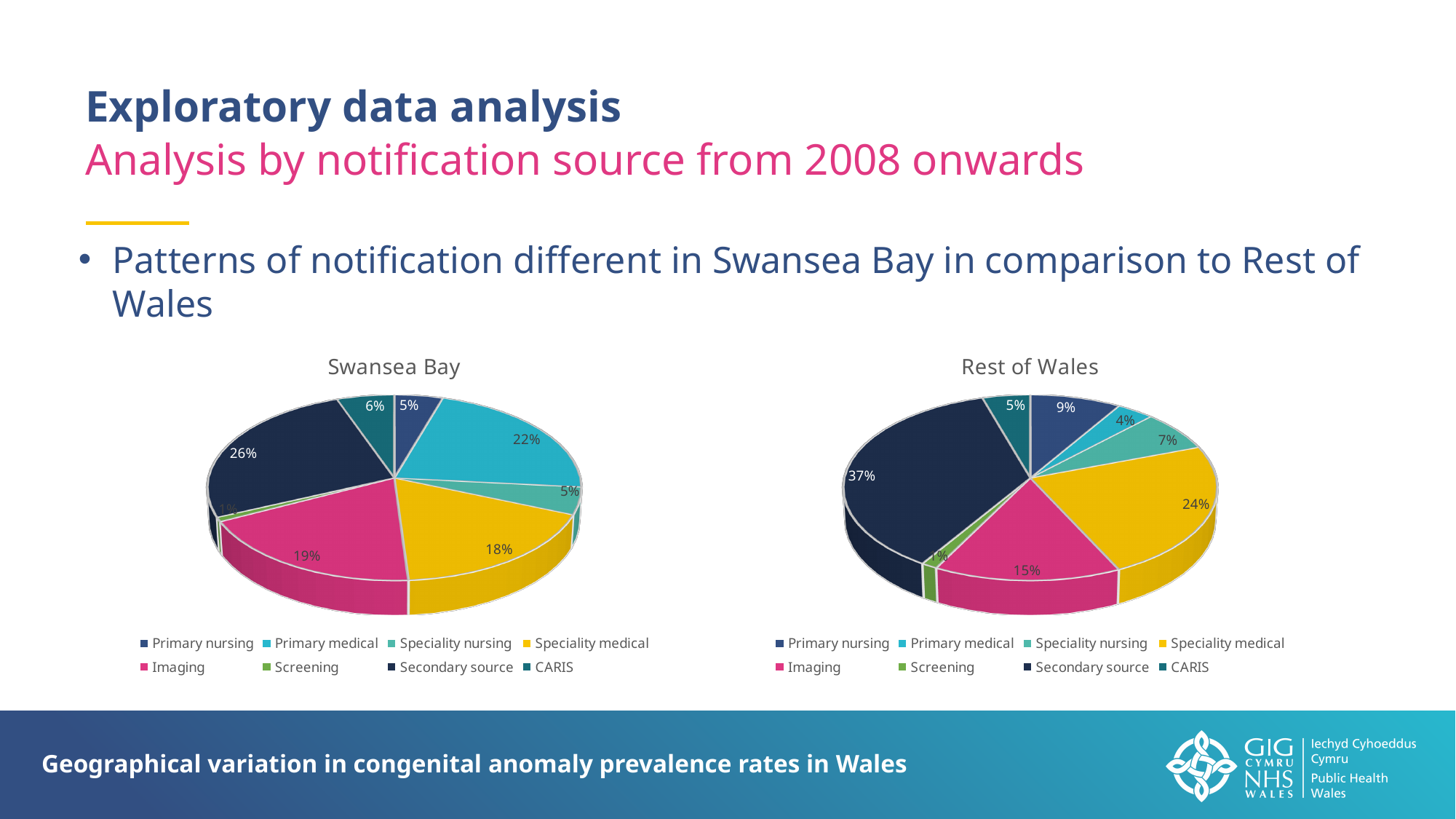
In the Swansea Bay pie chart, what percentage is shown for Primary medical? 22% In the Rest of Wales pie chart, what share does Primary nursing account for? 9% In the Rest of Wales pie chart, what share does Secondary source account for? 37% In the Swansea Bay pie chart, what share does Secondary source account for? 26% What colour represents Imaging in the pie charts? Pink In the Swansea Bay pie chart, which notification source has the largest share? Secondary source What is the difference between the Imaging share in Swansea Bay and the Imaging share in Rest of Wales? 4% How many notification sources are listed in the legend of the Swansea Bay chart? 8 In the Rest of Wales pie chart, what percentage is shown for Speciality medical? 24% Which is larger: the Primary medical share in Swansea Bay or the Primary medical share in Rest of Wales? Swansea Bay In the Rest of Wales pie chart, which notification source has the smallest share? Screening What type of chart is used for the Rest of Wales data? Pie chart